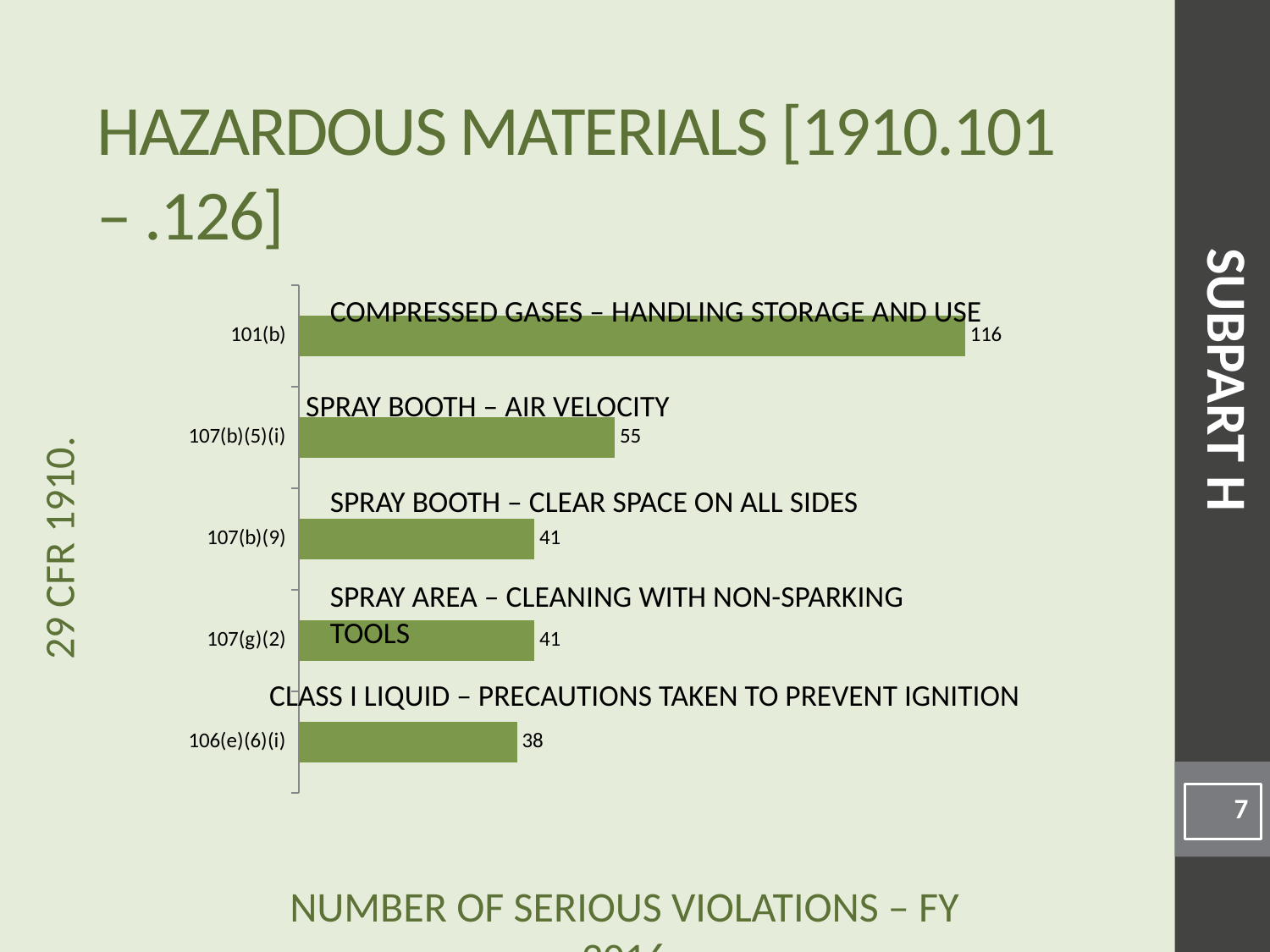
Which has more serious violations, 107(b)(5)(i) or 107(g)(2)? 107(b)(5)(i) What is the number of serious violations for 106(e)(6)(i)? 38 What is the number of serious violations for 101(b)? 116 Which standard is described as 'SPRAY BOOTH – AIR VELOCITY'? 107(b)(5)(i) How many standards (bars) are shown in the chart? 5 What is the difference between the number of serious violations for 101(b) and 107(b)(5)(i)? 61 What kind of chart is shown on the slide? Bar chart What is the number of serious violations for 107(b)(5)(i)? 55 What is the difference between the number of serious violations for 107(b)(9) and 106(e)(6)(i)? 3 Which standard has the lowest number of serious violations? 106(e)(6)(i) What is the number of serious violations for 107(b)(9)? 41 Which standard has the highest number of serious violations? 101(b)